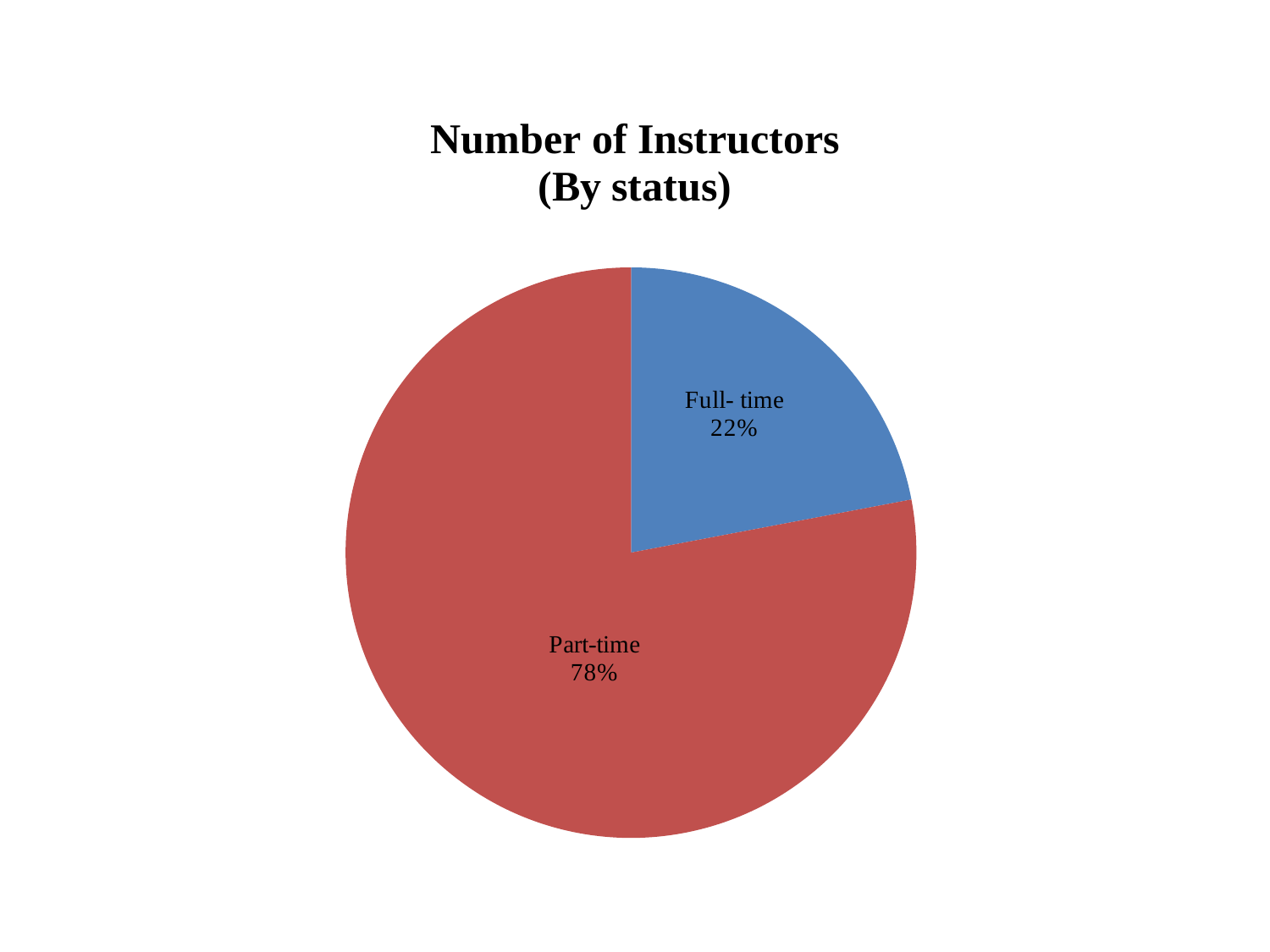
What kind of chart is shown on the slide? Pie chart Which status has the largest share of instructors? Part-time What is the difference in percentage points between the Part-time and Full-time shares? 56 What share of instructors are Part-time? 78% How many slices does the pie chart have? 2 What share of instructors are Full-time? 22% What is the title of the chart? Number of Instructors (By status) Which is larger, the Part-time share or the Full-time share? Part-time What colour is the Part-time slice? Red Which status has the smallest share of instructors? Full-time